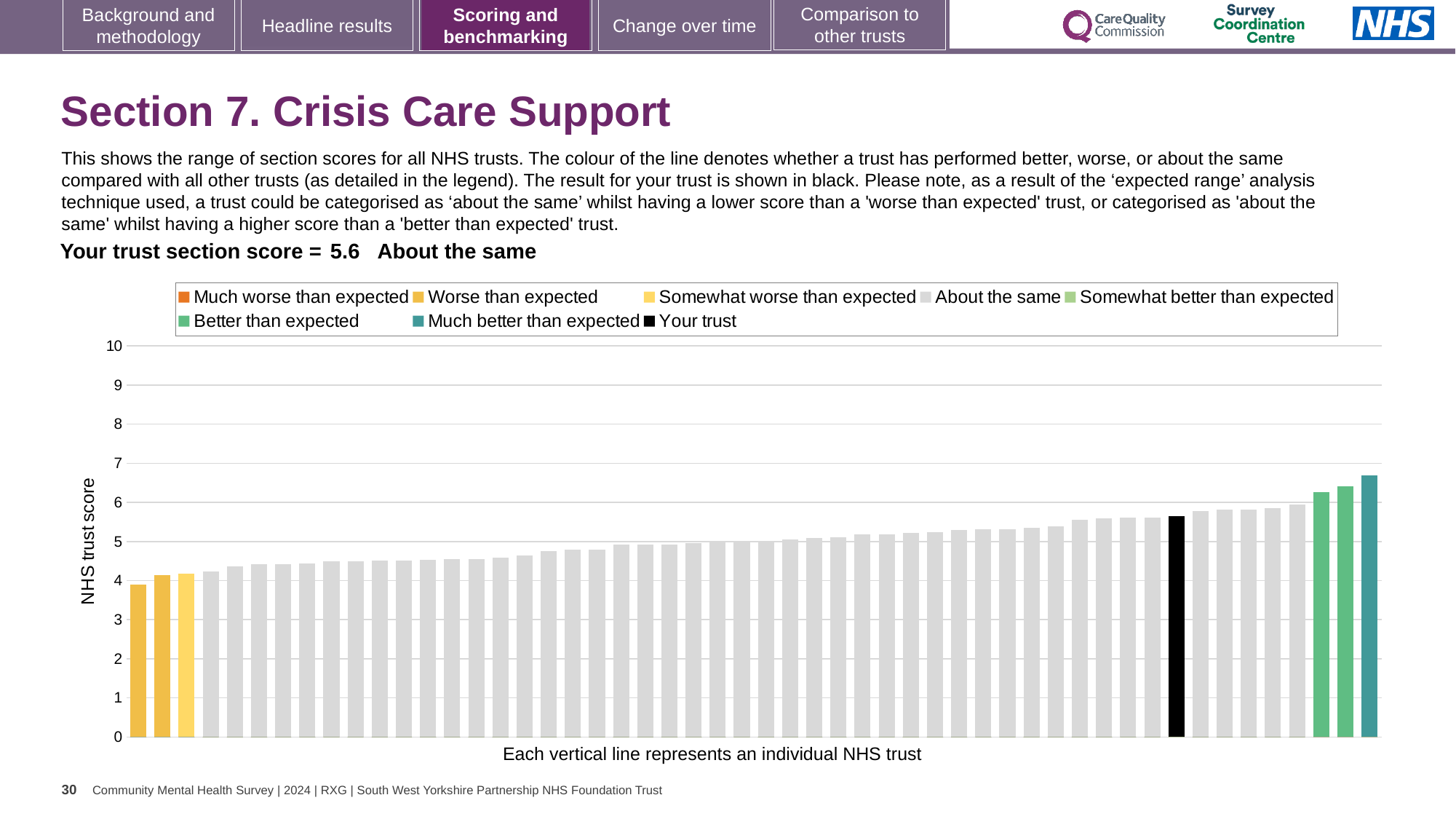
Which performance category is your trust's section score placed in? About the same What kind of chart is shown on the slide? bar chart Do the bar values rise or fall from left to right along the x axis? rise How many bars are coloured as 'Much better than expected'? 1 How many entries does the chart legend list? 8 Is the value of the lowest bar in the chart greater or less than 4? less What is the label on the y axis of the chart? NHS trust score What is the section score for your trust shown on the slide? 5.6 Which legend category does the highest bar in the chart belong to? Much better than expected Is the value for your trust (the black bar) greater or less than 5? greater Is the value of the highest bar in the chart greater or less than 6? greater Which legend category does the lowest bar in the chart belong to? Worse than expected